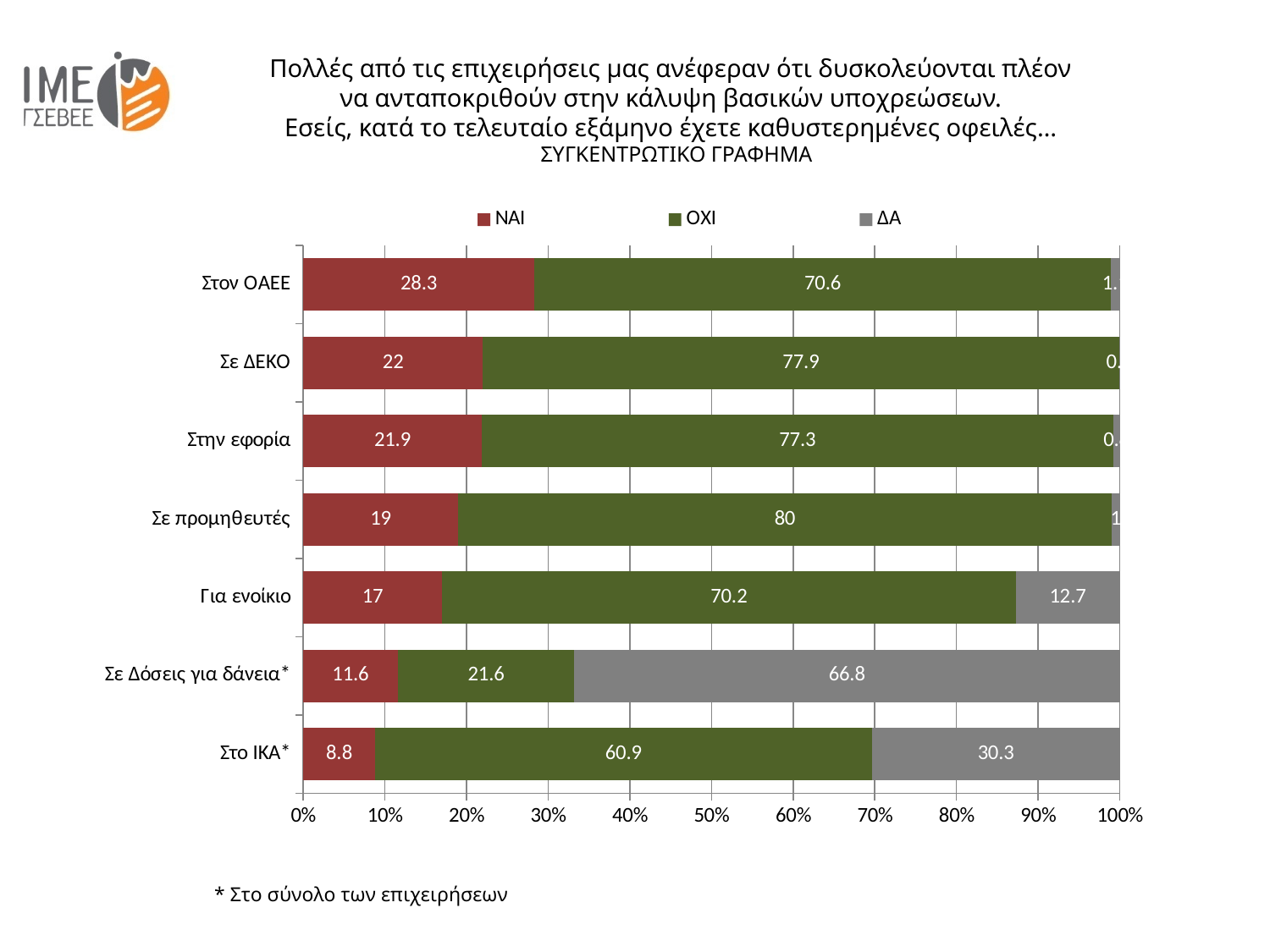
How many series does the legend list? 3 How many categories are shown on the chart? 7 What is the ΟΧΙ value for Στο ΙΚΑ*? 60.9 What is the ΝΑΙ value for Στον ΟΑΕΕ? 28.3 What is the difference between the ΝΑΙ values for Στον ΟΑΕΕ and Σε ΔΕΚΟ? 6.3 Which category has the highest ΝΑΙ value? Στον ΟΑΕΕ Which category has the lowest ΝΑΙ value? Στο ΙΚΑ* What kind of chart is shown on the slide? Stacked bar chart Which category has the highest ΟΧΙ value? Σε προμηθευτές What is the ΔΑ value for Σε Δόσεις για δάνεια*? 66.8 Which has the larger ΔΑ value, Στο ΙΚΑ* or Για ενοίκιο? Στο ΙΚΑ* What is the ΟΧΙ value for Σε προμηθευτές? 80